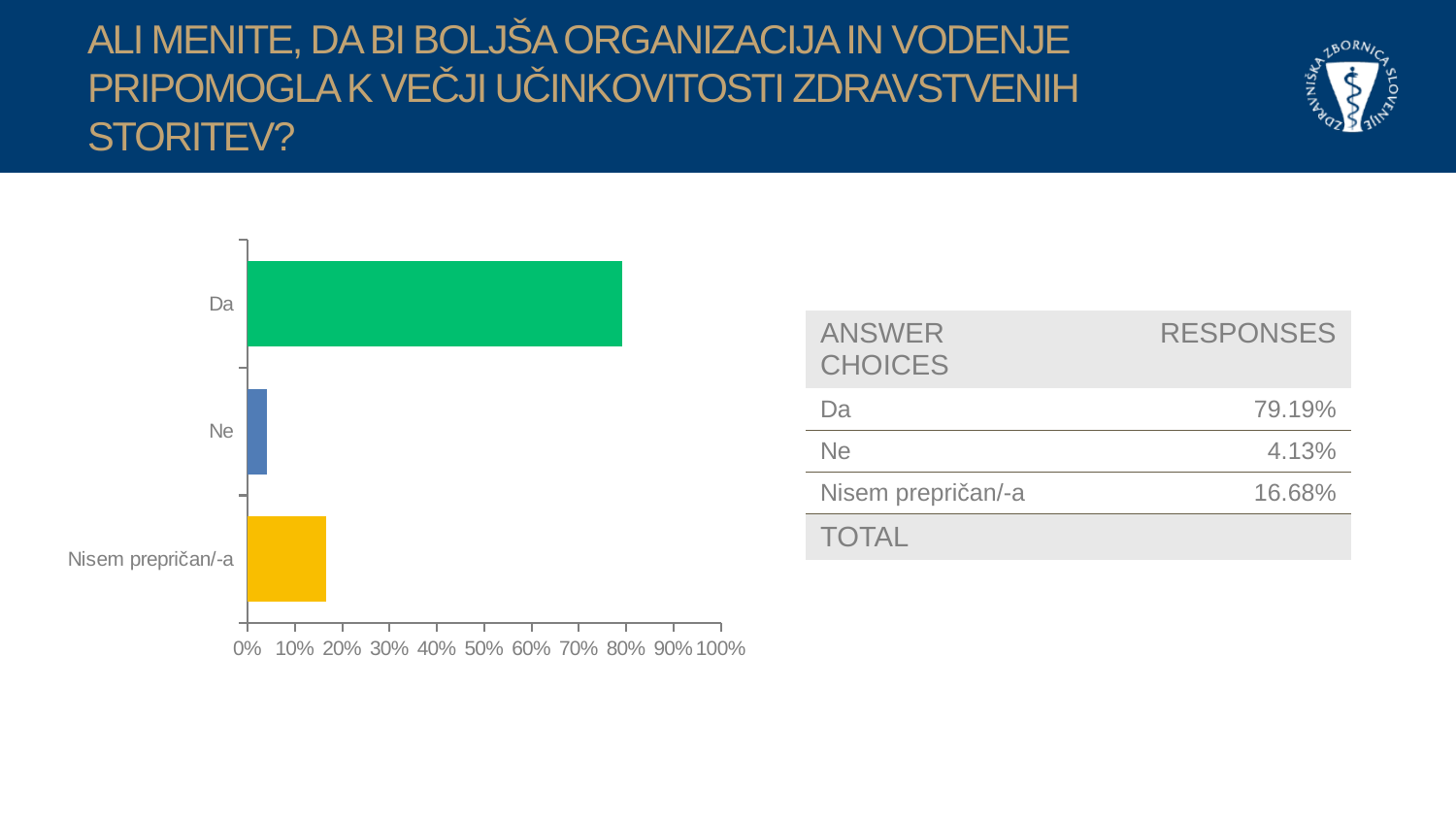
What is the value for Da? 79.19% What colour is the bar for Da? green What kind of chart is shown on the slide? bar chart Which is larger, the value for Ne or the value for Nisem prepričan/-a? Nisem prepričan/-a How many categories does the bar chart show? 3 What is the difference between the values for Da and Nisem prepričan/-a? 62.51% What is the value for Nisem prepričan/-a? 16.68% Is the value for Nisem prepričan/-a greater or less than 20%? less What is the value for Ne? 4.13% Which category has the lowest value in the bar chart? Ne Is the value for Da greater or less than 70%? greater Which category has the highest value in the bar chart? Da